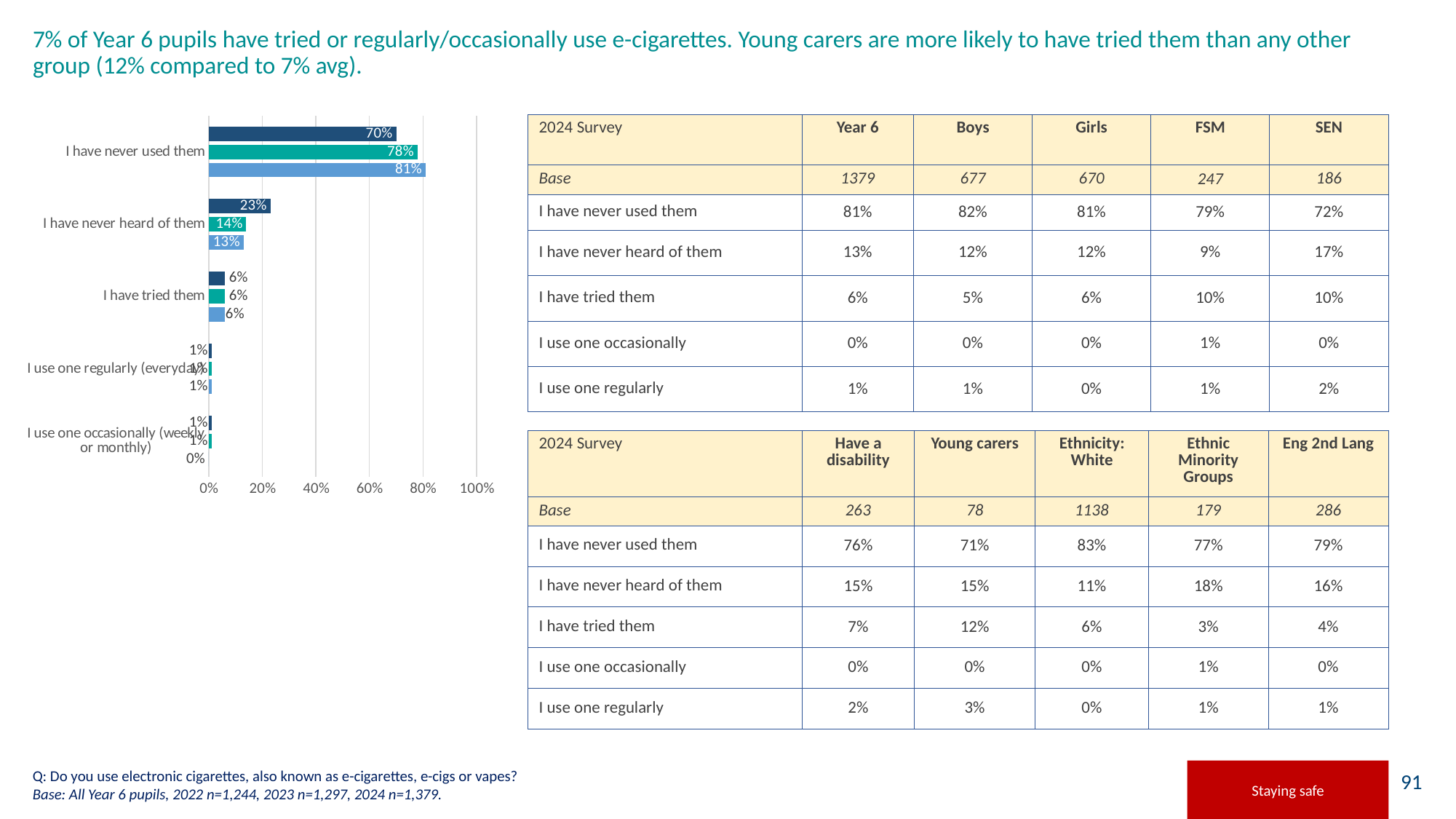
What is the maximum value shown on the x axis of the bar chart? 100% In the bar chart, is the teal bar for "I have never used them" greater or less than 60%? greater In the bar chart, what is the value of the dark blue bar for "I have never heard of them"? 23% In the bar chart, what is the value of the light blue bar for "I have never used them"? 81% In the bar chart, which category has the highest value among the light blue bars? I have never used them How many response categories are plotted in the bar chart? 5 In the bar chart, for "I have never used them", do the values rise or fall going from the dark blue bar to the light blue bar? rise In the bar chart, for "I have never heard of them", which is larger: the dark blue bar or the teal bar? the dark blue bar In the bar chart, what is the difference between the light blue bar and the dark blue bar for "I have never used them"? 11 percentage points What kind of chart is shown on the left of the slide? bar chart In the bar chart, what is the value of the light blue bar for "I use one occasionally (weekly or monthly)"? 0% In the bar chart, what is the value of the teal bar for "I have tried them"? 6%